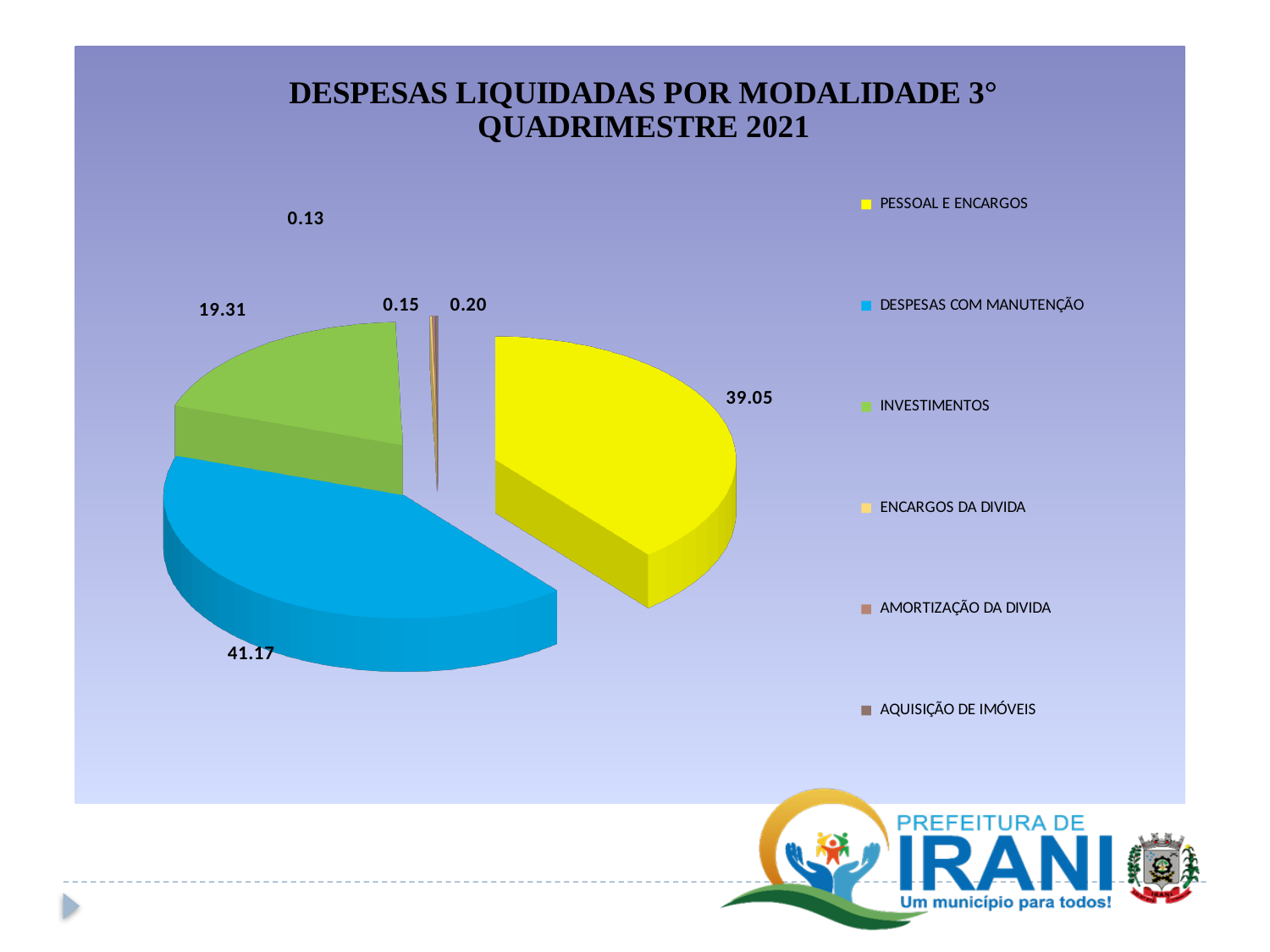
Which is larger, INVESTIMENTOS or PESSOAL E ENCARGOS? PESSOAL E ENCARGOS Which is larger, PESSOAL E ENCARGOS or DESPESAS COM MANUTENÇÃO? DESPESAS COM MANUTENÇÃO What is the value shown for PESSOAL E ENCARGOS? 39.05 Which category has the largest slice of the pie? DESPESAS COM MANUTENÇÃO What is the difference between the values for PESSOAL E ENCARGOS and INVESTIMENTOS? 19.74 How many categories does the legend list? 6 What is the smallest value labelled on the pie chart? 0.13 What is the title of the chart? DESPESAS LIQUIDADAS POR MODALIDADE 3° QUADRIMESTRE 2021 What is the difference between the values for DESPESAS COM MANUTENÇÃO and PESSOAL E ENCARGOS? 2.12 What is the value shown for INVESTIMENTOS? 19.31 What kind of chart is shown on the slide? Pie chart What is the value shown for DESPESAS COM MANUTENÇÃO? 41.17